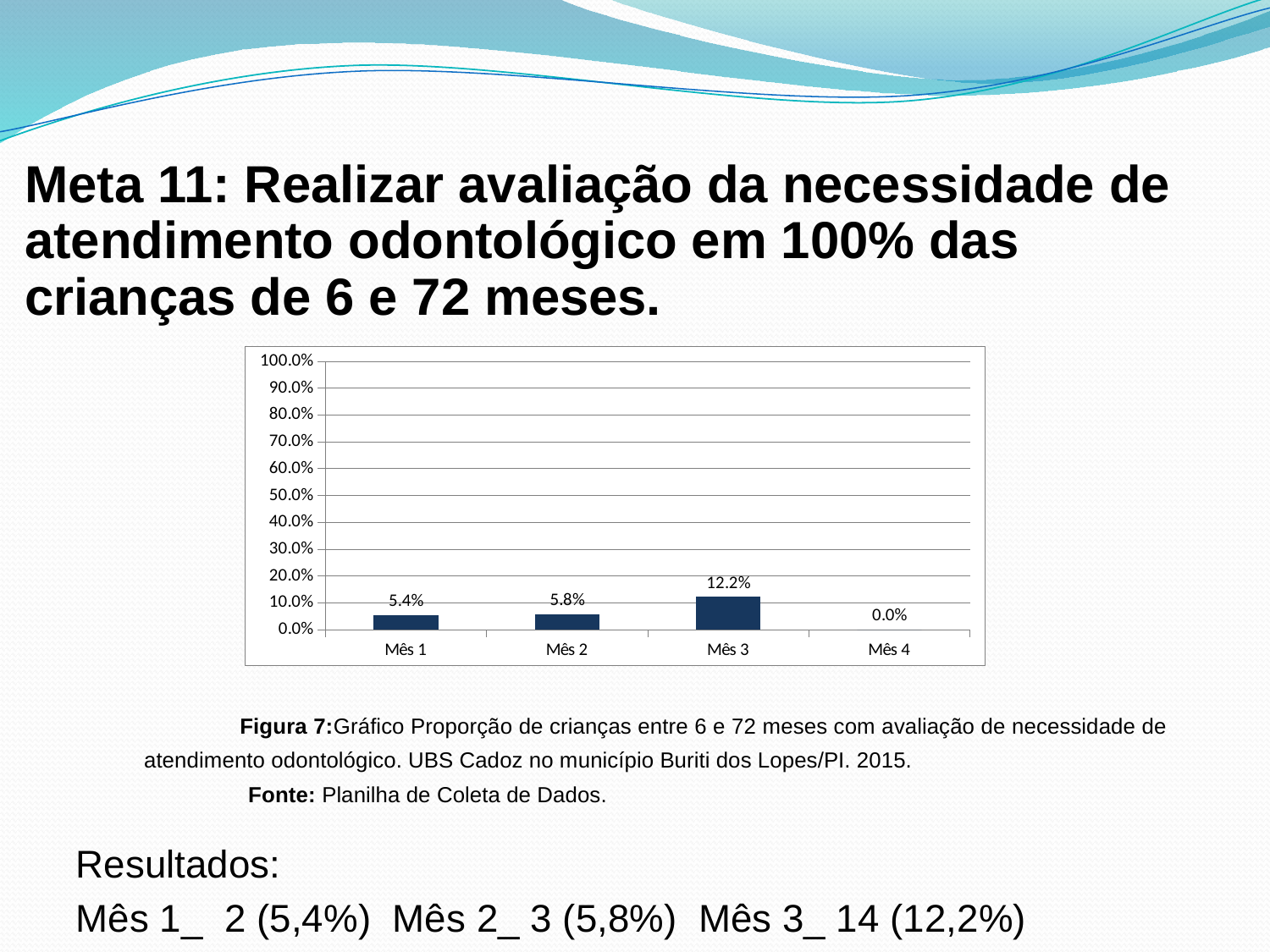
What is the maximum value shown on the y axis? 100.0% What is the value for Mês 4? 0.0% What kind of chart is shown on the slide? bar chart Is the value for Mês 3 greater or less than 10.0%? greater Which is larger, the value for Mês 1 or the value for Mês 3? Mês 3 What is the difference between the values for Mês 3 and Mês 2? 6.4% Do the values rise or fall from Mês 1 to Mês 3? rise Which month has the lowest value? Mês 4 How many months are shown on the x axis? 4 Which month has the highest value? Mês 3 What is the value for Mês 3? 12.2% What is the value for Mês 1? 5.4%